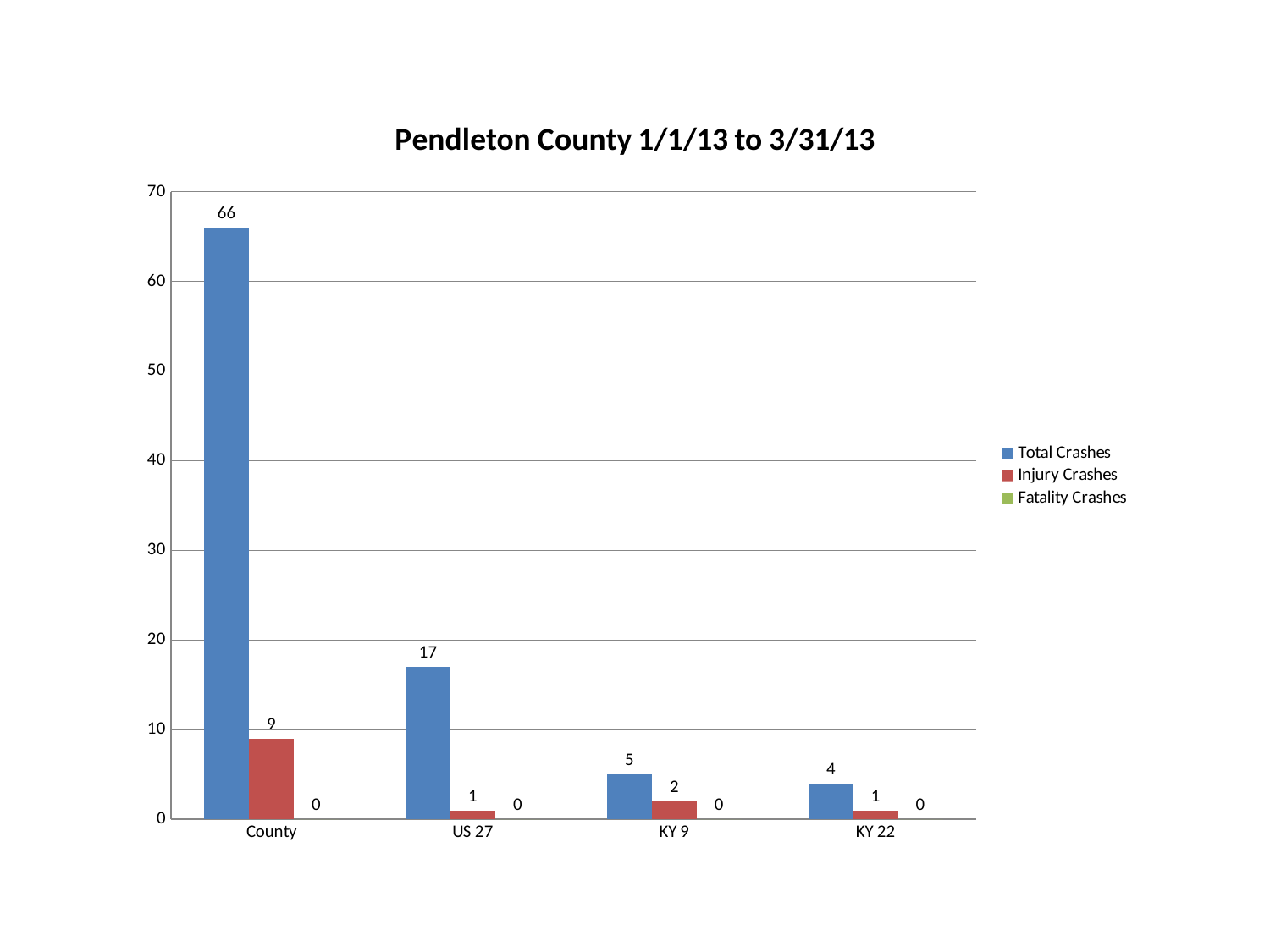
Is the value of Total Crashes for County greater or less than 60? greater What is the value of Total Crashes for US 27? 17 Which category has the highest Injury Crashes? County Which is larger, Total Crashes for KY 9 or Total Crashes for KY 22? KY 9 What is the difference between Total Crashes for County and Total Crashes for US 27? 49 Which category has the lowest Total Crashes? KY 22 How many categories are shown on the x axis? 4 What is the value of Injury Crashes for KY 9? 2 What is the value of Total Crashes for County? 66 What kind of chart is shown on the slide? bar chart What is the title of the chart? Pendleton County 1/1/13 to 3/31/13 How many series does the legend list? 3